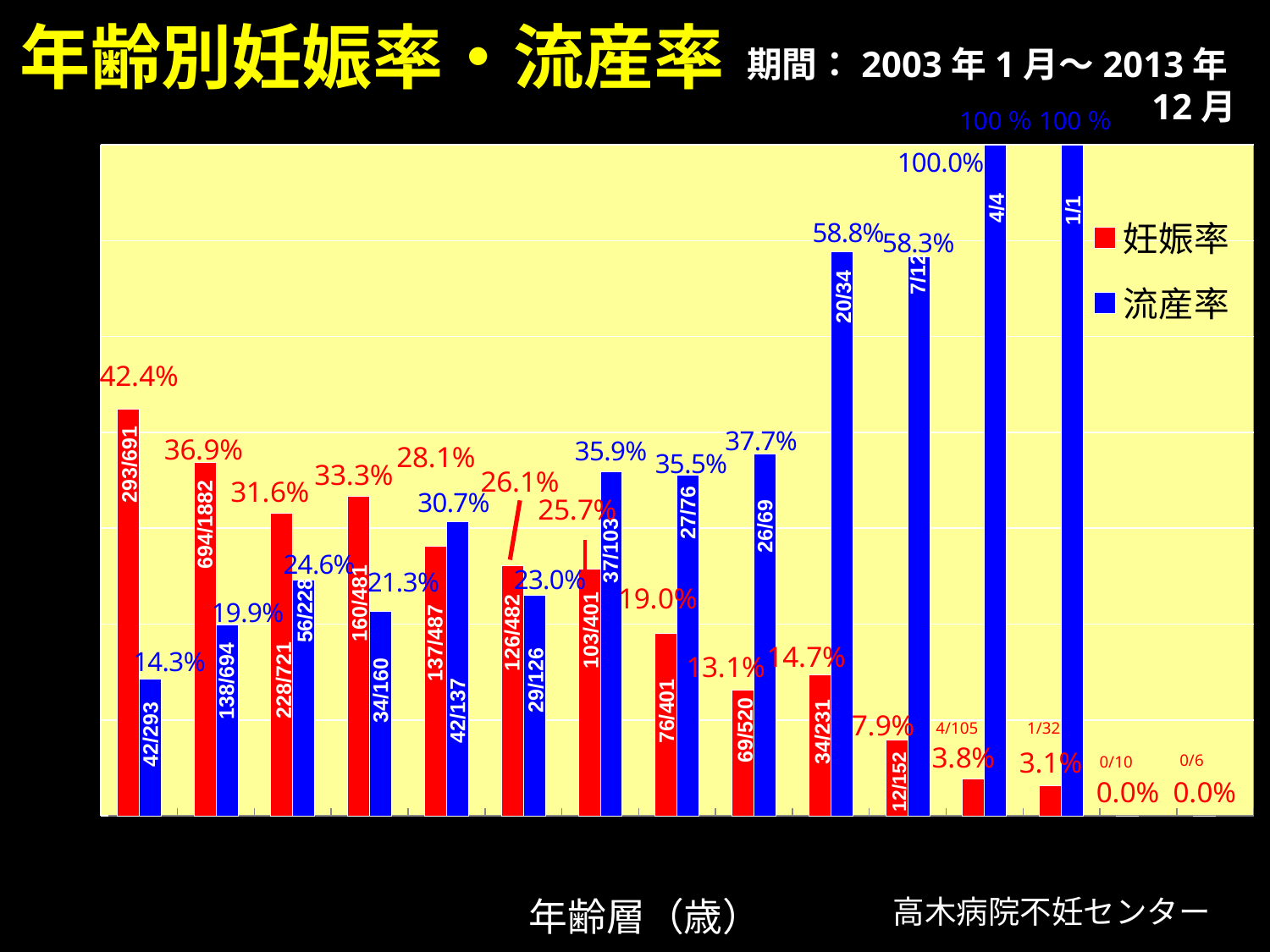
What is the 流産率 for the group labelled 20/34? 58.8% What is the difference between the 妊娠率 of the first group (42.4%) and the second group (36.9%)? 5.5% How many series does the legend list? 2 What kind of chart is shown on the slide? bar chart What is the 妊娠率 for the group labelled 694/1882? 36.9% What are the two series named in the legend? 妊娠率 and 流産率 What is the highest 流産率 value shown on the chart? 100.0% Does the 妊娠率 generally rise or fall from left to right across the age groups? fall In the first (leftmost) group, which is larger, 妊娠率 or 流産率? 妊娠率 What is the title of the chart? 年齢別妊娠率・流産率 What is the highest 妊娠率 value shown on the chart? 42.4% What is the lowest 流産率 value shown on the chart? 14.3%